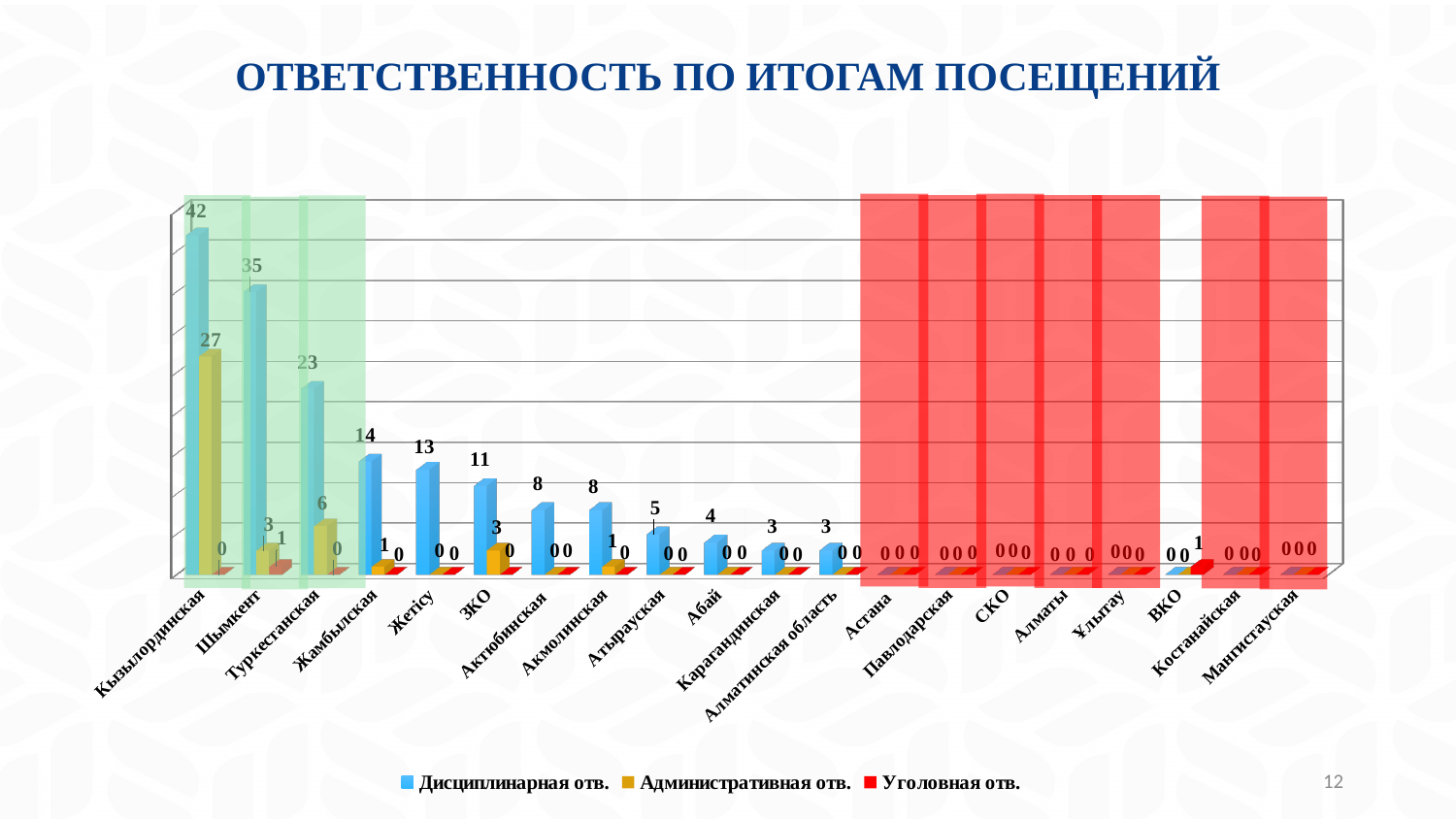
How many categories are shown on the x axis? 20 What is the value of Дисциплинарная отв. for Кызылординская? 42 What is the difference between the Дисциплинарная отв. values for Кызылординская and Шымкент? 7 Which category has the highest value for Дисциплинарная отв.? Кызылординская What is the value of Административная отв. for Кызылординская? 27 How many series does the legend list? 3 Which has the larger Дисциплинарная отв. value, Жамбылская or Жетісу? Жамбылская What is the title of the chart? ОТВЕТСТВЕННОСТЬ ПО ИТОГАМ ПОСЕЩЕНИЙ What is the value of Уголовная отв. for ВКО? 1 What kind of chart is shown on the slide? Bar chart What is the value of Дисциплинарная отв. for Туркестанская? 23 What is the value of Административная отв. for ЗКО? 3